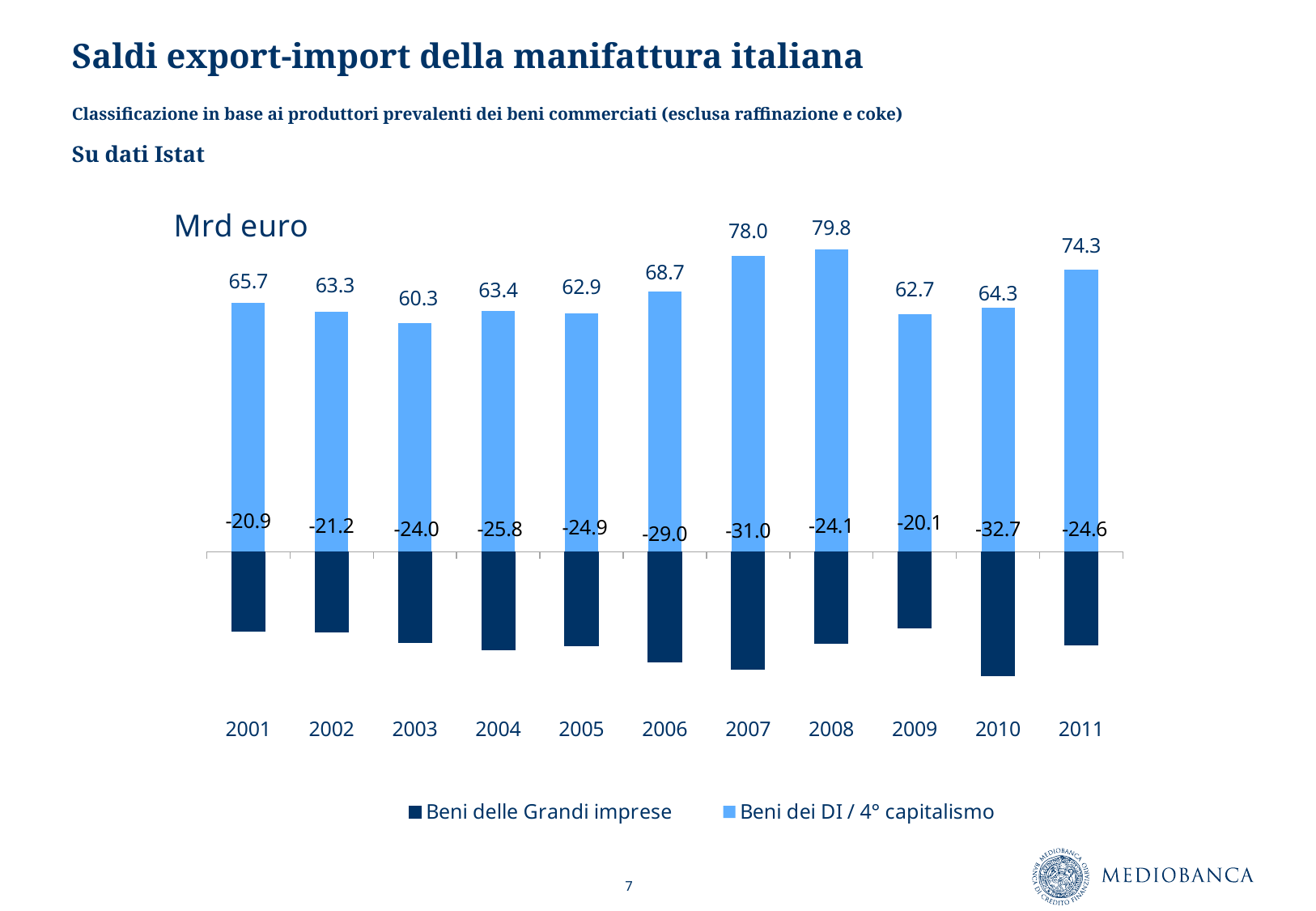
In which year is the value for Beni delle Grandi imprese lowest (most negative)? 2010 How many series does the legend list? 2 What is the value for Beni delle Grandi imprese in 2009? -20.1 What is the value for Beni dei DI / 4° capitalismo in 2003? 60.3 What is the value for Beni delle Grandi imprese in 2010? -32.7 In which year is the value for Beni dei DI / 4° capitalismo lowest? 2003 How many years are shown on the x axis? 11 In which year is the value for Beni dei DI / 4° capitalismo highest? 2008 Which year has a larger value for Beni dei DI / 4° capitalismo, 2006 or 2011? 2011 What is the difference between the Beni dei DI / 4° capitalismo values for 2008 and 2007? 1.8 What is the value for Beni dei DI / 4° capitalismo in 2008? 79.8 What kind of chart is shown on the slide? Bar chart